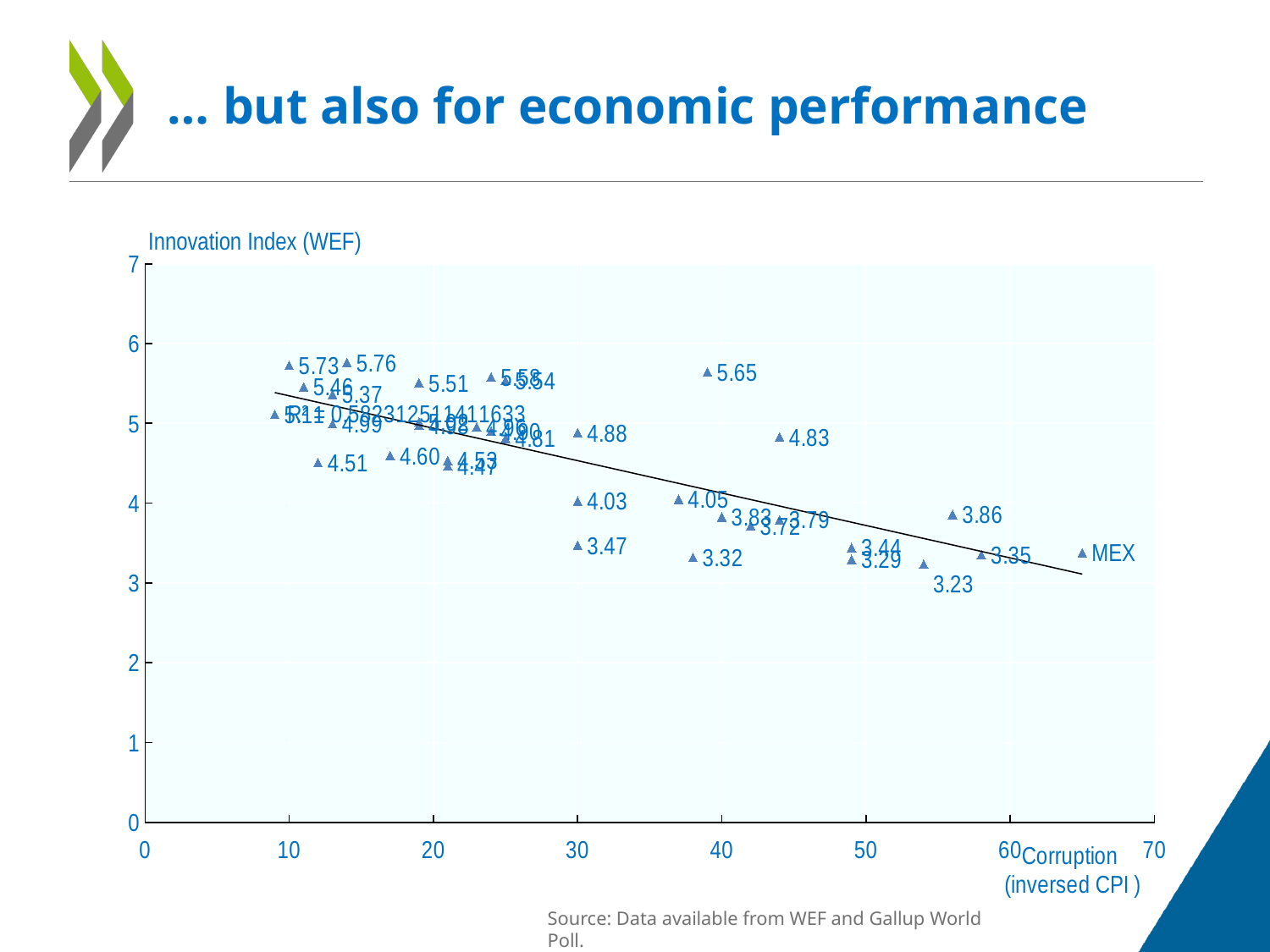
Is the Corruption (inversed CPI) value for the point labelled 5.65 greater or less than 30? greater Is the Innovation Index value for the point labelled MEX greater or less than 4? less Which has the higher Innovation Index: the point labelled 5.65 or the point labelled 4.83? 5.65 What is the lowest Innovation Index value labelled on the chart? 3.23 Is the Corruption (inversed CPI) value for the point labelled MEX greater or less than 60? greater What is the difference between the highest labelled value (5.76) and the lowest labelled value (3.23) on the chart? 2.53 What is the label of the vertical axis of the chart? Innovation Index (WEF) What is the highest value shown on the vertical axis of the chart? 7 According to the trend line, does the Innovation Index rise or fall as Corruption (inversed CPI) increases? Fall What is the label of the horizontal axis of the chart? Corruption (inversed CPI) What kind of chart is shown on the slide? Scatter chart What is the highest Innovation Index value labelled on the chart? 5.76